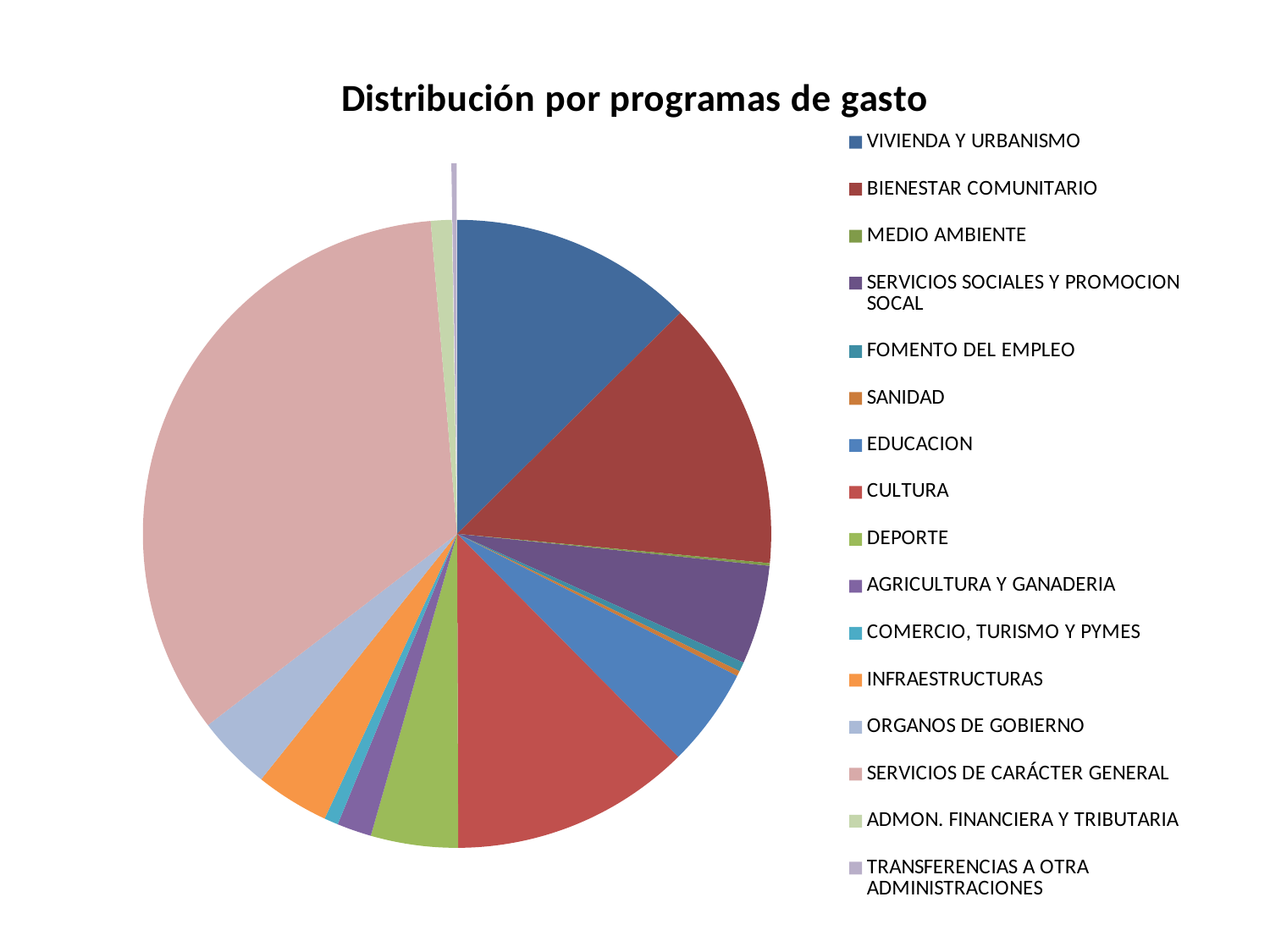
Which slice is larger, BIENESTAR COMUNITARIO or INFRAESTRUCTURAS? BIENESTAR COMUNITARIO Which slice is larger, ORGANOS DE GOBIERNO or SANIDAD? ORGANOS DE GOBIERNO How many categories (slices) does the pie chart have? 16 Which category has the largest slice of the pie? SERVICIOS DE CARÁCTER GENERAL What is the first entry listed in the legend? VIVIENDA Y URBANISMO Which slice is larger, SERVICIOS DE CARÁCTER GENERAL or CULTURA? SERVICIOS DE CARÁCTER GENERAL What is the title of the chart? Distribución por programas de gasto What kind of chart is shown on the slide? Pie chart